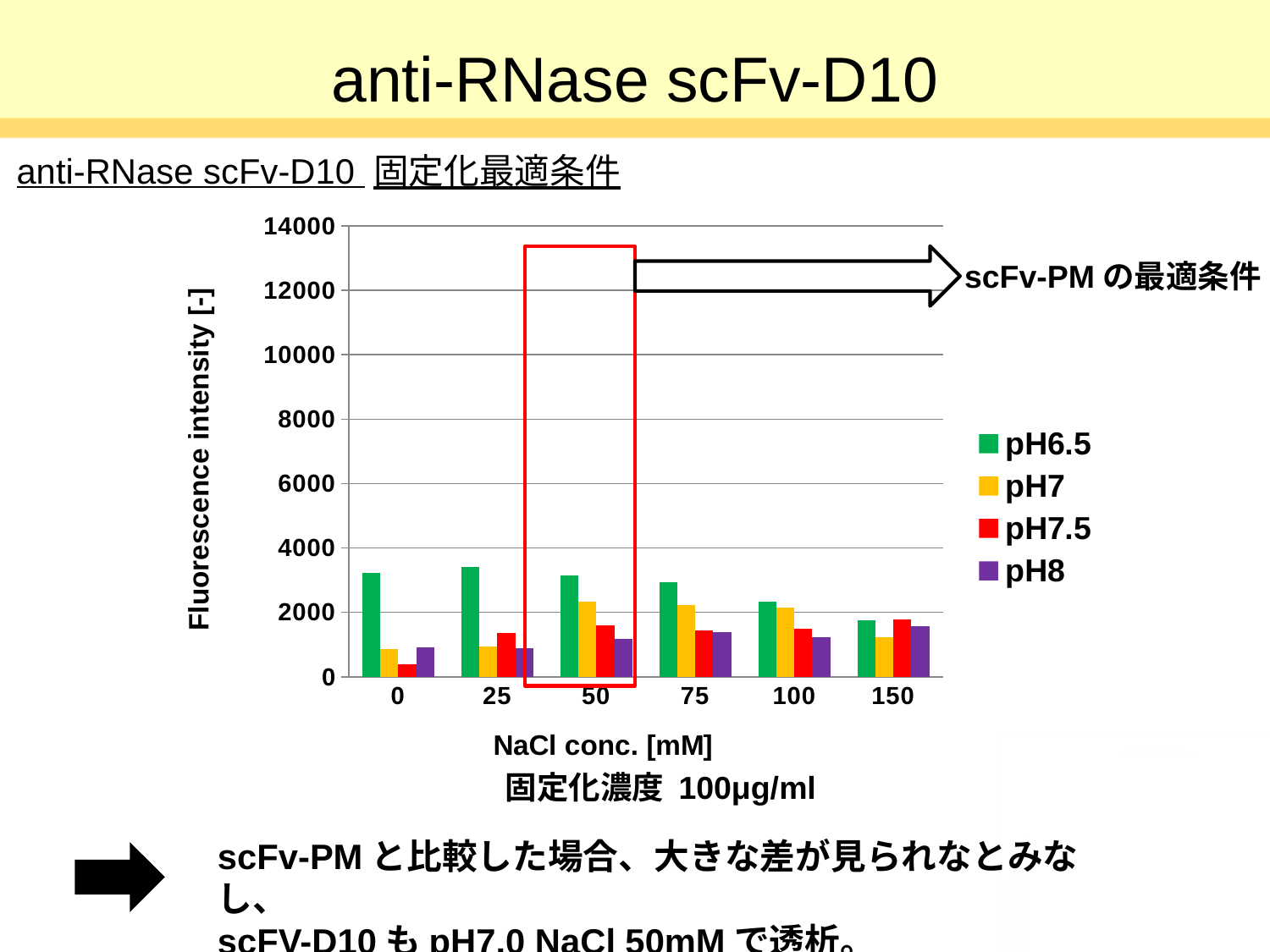
Is the value for pH7.5 at 0 mM NaCl greater or less than 2000? less At 50 mM NaCl, which is larger: the value for pH7 or the value for pH8? pH7 What is the label of the y axis? Fluorescence intensity [-] Is the value for pH7 at 50 mM NaCl greater or less than 4000? less Which series has the lowest value at 0 mM NaCl? pH7.5 Is the value for pH6.5 at 0 mM NaCl greater or less than 2000? greater What kind of chart is shown on the slide? bar chart How many series does the legend list? 4 Does the value for pH6.5 rise or fall from 50 mM to 150 mM NaCl? fall Which series has the highest value at 25 mM NaCl? pH6.5 What is the label of the x axis? NaCl conc. [mM] How many NaCl concentration categories are shown on the x axis? 6